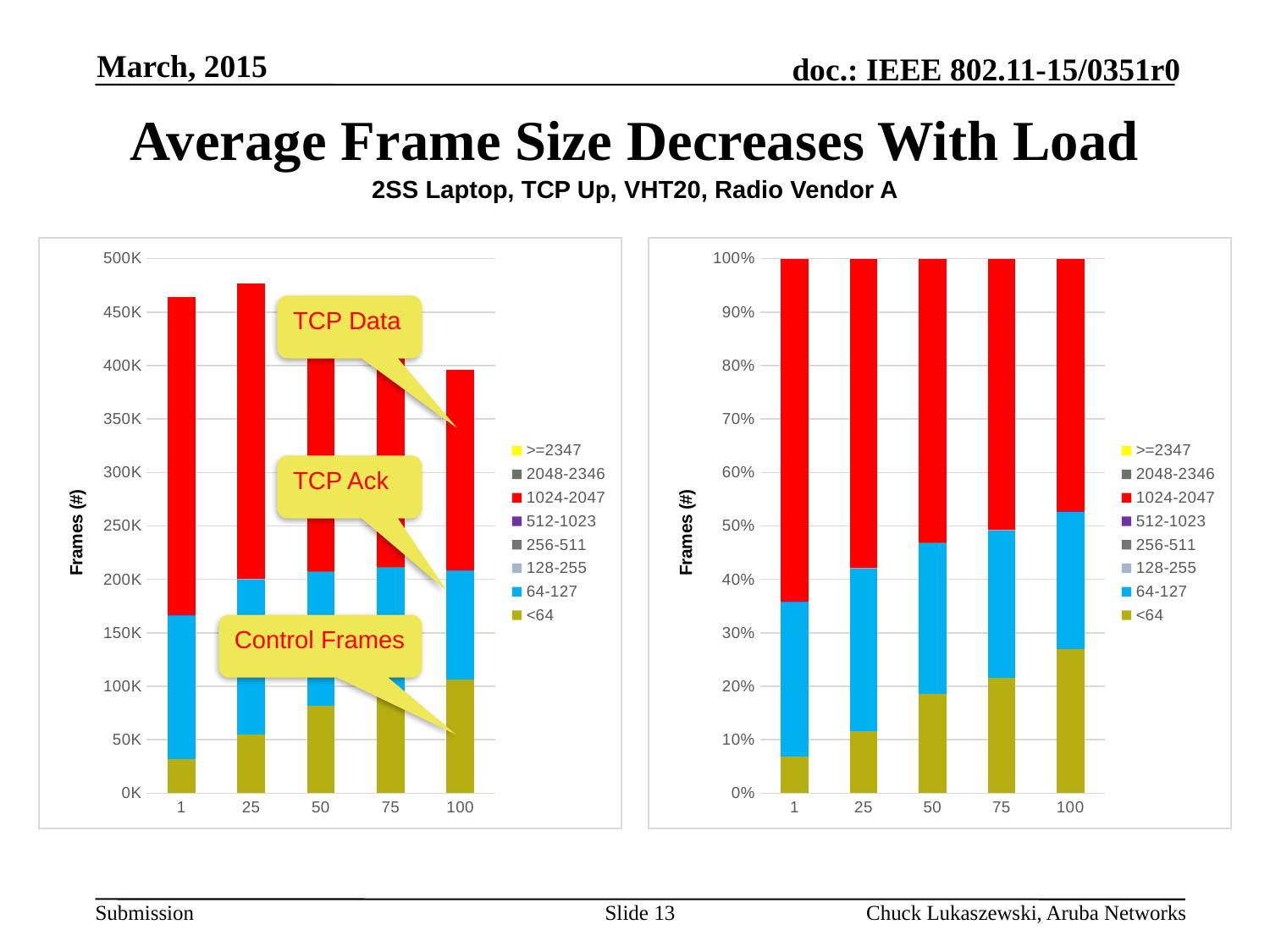
In the left chart, is the <64 segment larger for category 100 or for category 1? 100 In the left chart, is the total bar height for category 100 greater or less than 450K? less In the left chart, which category has the shortest total bar? 100 In the right chart, which colour represents the 1024-2047 series? red How many categories are shown on the x axis of the right chart? 5 What kind of chart is the left chart on the slide? stacked bar chart In the left chart, is the total bar height for category 25 greater or less than 450K? greater In the right chart, does the share of <64 frames rise or fall as the x-axis value increases from 1 to 100? rise In the right chart, is the <64 share for category 100 greater or less than 20%? greater How many series does the legend of the left chart list? 8 In the left chart, which category has the tallest total bar? 25